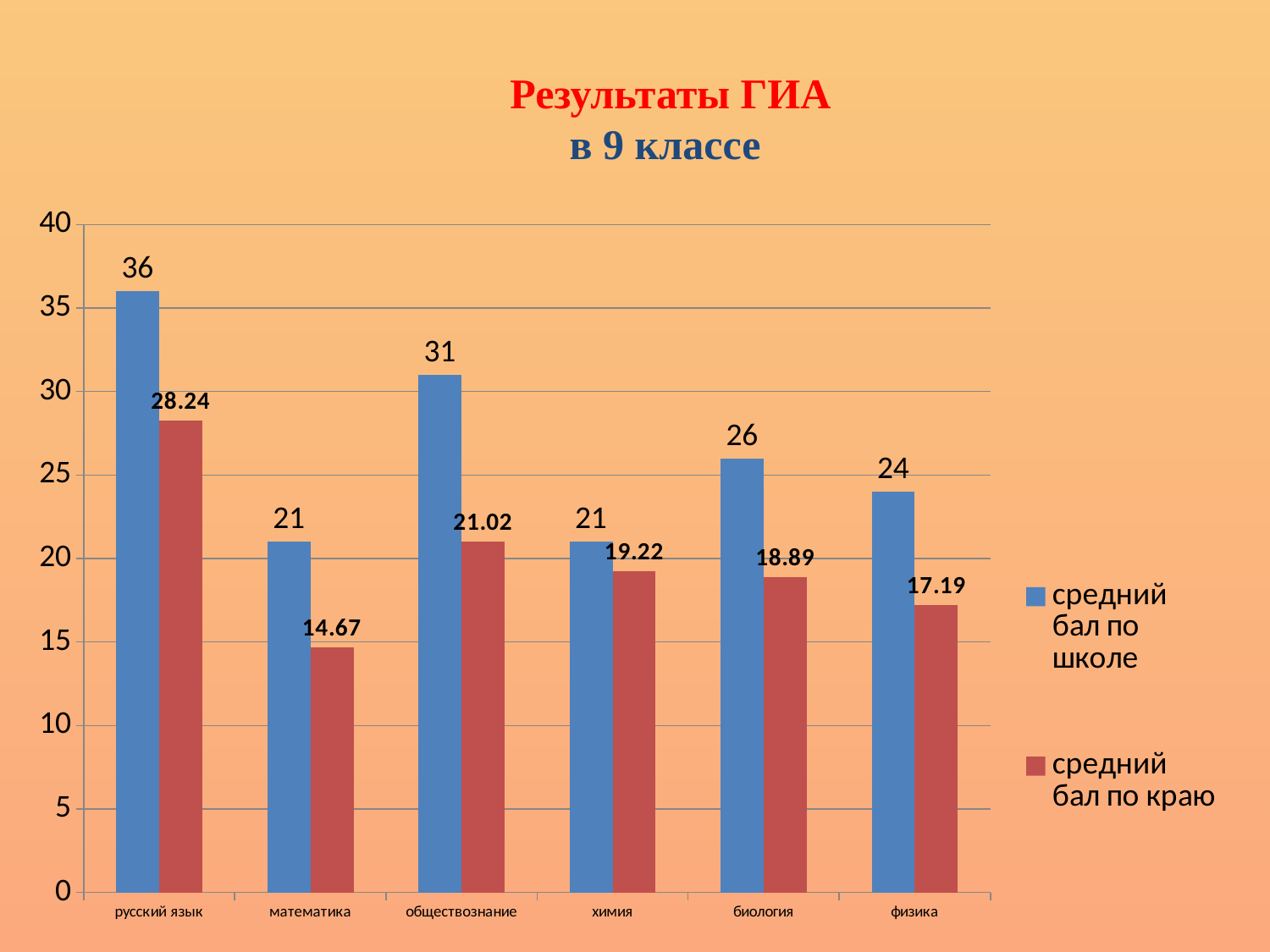
What kind of chart is shown on the slide? bar chart How many series does the legend list? 2 What is the title of the chart? Результаты ГИА в 9 классе What is the value of 'средний бал по краю' for физика? 17.19 How many subjects are shown on the x axis? 6 Which is larger for биология: 'средний бал по школе' or 'средний бал по краю'? средний бал по школе What is the value of 'средний бал по школе' for русский язык? 36 Is the value of 'средний бал по краю' for химия greater or less than 20? less Which subject has the highest 'средний бал по школе'? русский язык Which subject has the lowest 'средний бал по краю'? математика What is the value of 'средний бал по краю' for математика? 14.67 What is the difference between 'средний бал по школе' and 'средний бал по краю' for обществознание? 9.98